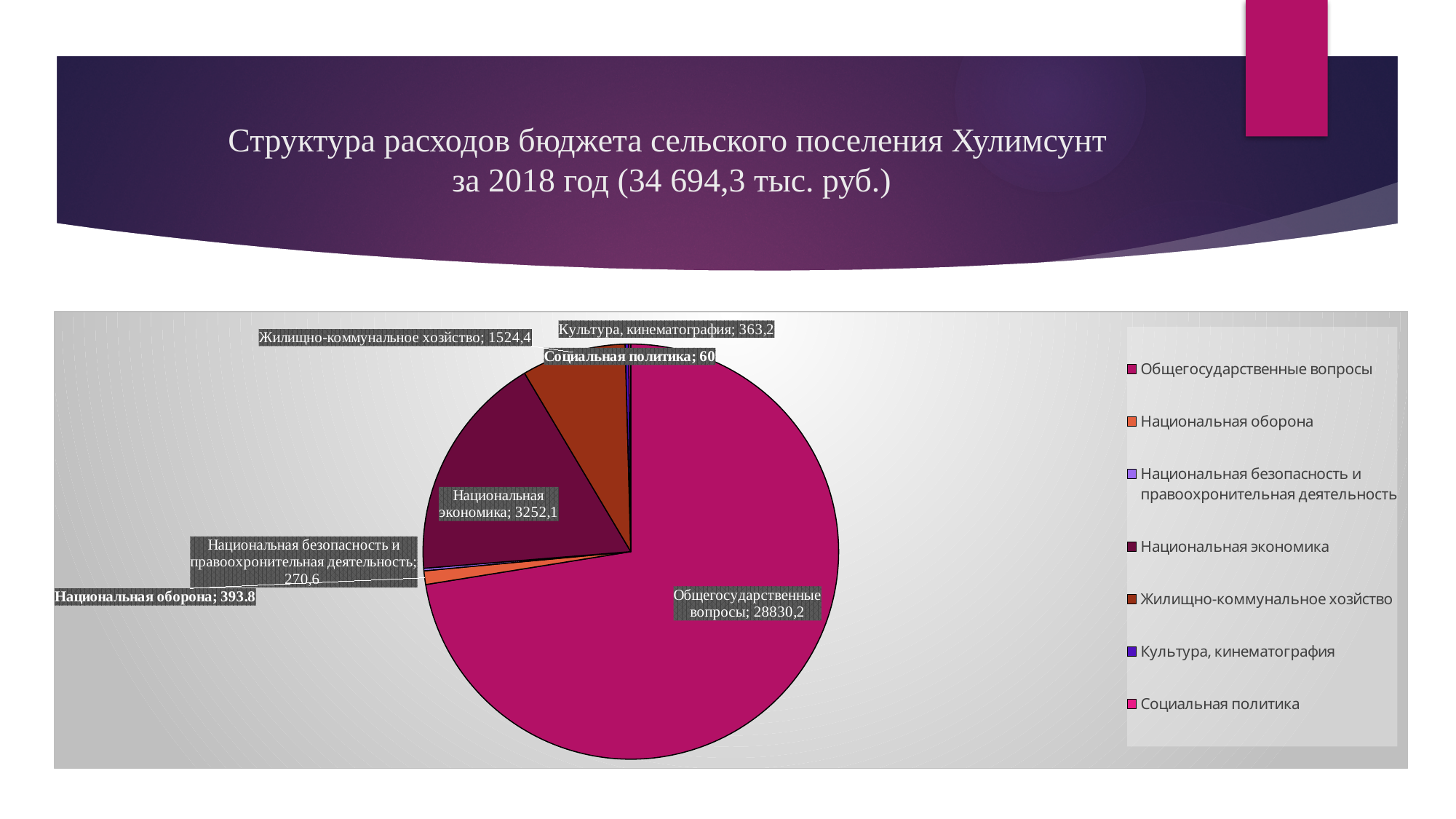
Which is larger: Национальная оборона or Культура, кинематография? Национальная оборона What is the difference between Национальная экономика and Жилищно-коммунальное хозяйство? 1727,7 What is the value for Национальная экономика? 3252,1 Which category has the largest slice of the pie? Общегосударственные вопросы What is the value for Национальная безопасность и правоохронительная деятельность? 270,6 What type of chart is shown on the slide? Pie chart What is the value for Общегосударственные вопросы? 28830,2 Which category has the smallest slice of the pie? Социальная политика What is the value for Социальная политика? 60 How many categories does the legend list? 7 What is the value for Жилищно-коммунальное хозяйство? 1524,4 What is the title of the chart on the slide? Структура расходов бюджета сельского поселения Хулимсунт за 2018 год (34 694,3 тыс. руб.)